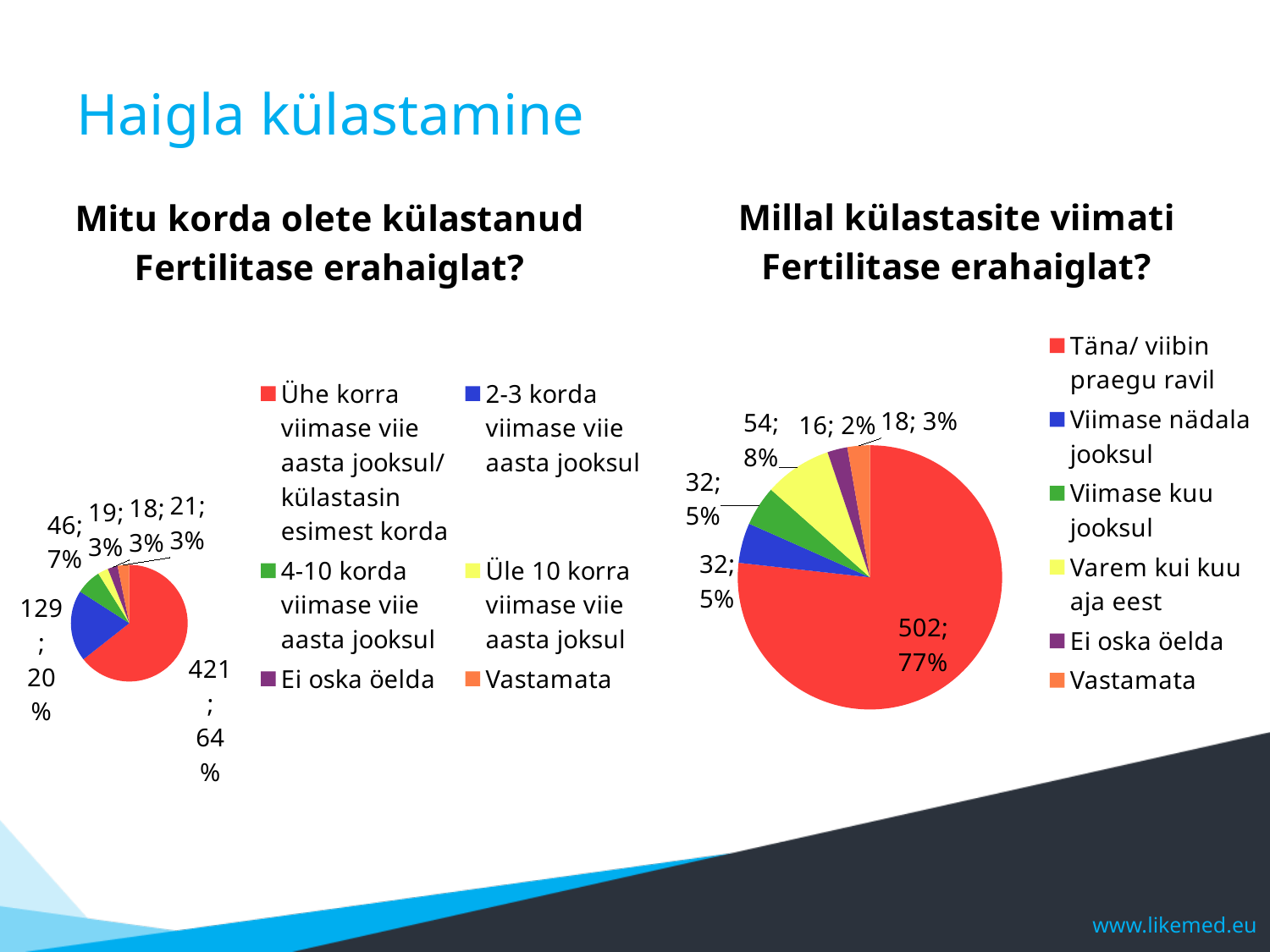
On the chart 'Mitu korda olete külastanud Fertilitase erahaiglat?', what percentage share does '4-10 korda viimase viie aasta jooksul' have? 7% On the chart 'Millal külastasite viimati Fertilitase erahaiglat?', what value is shown for 'Varem kui kuu aja eest'? 54; 8% On the chart 'Mitu korda olete külastanud Fertilitase erahaiglat?', which category has the largest slice? Ühe korra viimase viie aasta jooksul/ külastasin esimest korda On the chart 'Millal külastasite viimati Fertilitase erahaiglat?', what colour is the slice for 'Viimase kuu jooksul'? Green On the chart 'Millal külastasite viimati Fertilitase erahaiglat?', which category has the smallest slice? Ei oska öelda On the chart 'Mitu korda olete külastanud Fertilitase erahaiglat?', what value is shown for '2-3 korda viimase viie aasta jooksul'? 129; 20% On the chart 'Mitu korda olete külastanud Fertilitase erahaiglat?', what value is shown for 'Ühe korra viimase viie aasta jooksul/ külastasin esimest korda'? 421; 64% On the chart 'Millal külastasite viimati Fertilitase erahaiglat?', which is larger: 'Varem kui kuu aja eest' or 'Vastamata'? Varem kui kuu aja eest On the chart 'Mitu korda olete külastanud Fertilitase erahaiglat?', how many categories does the legend list? 6 On the chart 'Millal külastasite viimati Fertilitase erahaiglat?', what value is shown for 'Täna/ viibin praegu ravil'? 502; 77% On the chart 'Millal külastasite viimati Fertilitase erahaiglat?', what is the difference between the count for 'Täna/ viibin praegu ravil' and the count for 'Varem kui kuu aja eest'? 448 What type of chart is used for 'Millal külastasite viimati Fertilitase erahaiglat?'? Pie chart